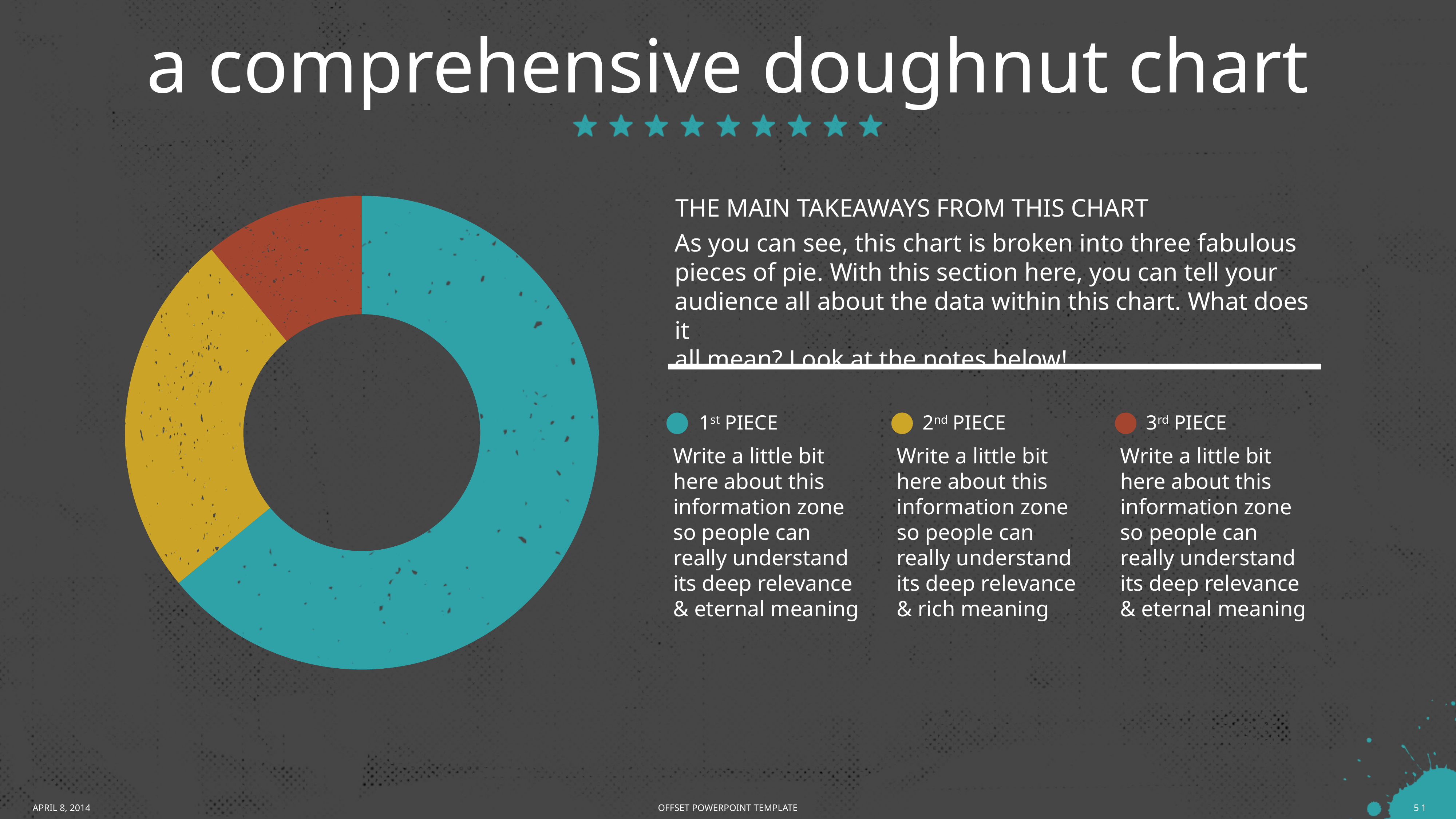
What is the title of the slide containing the doughnut chart? a comprehensive doughnut chart Which piece takes up the largest share of the doughnut chart? 1st PIECE What kind of chart is shown on the slide? Doughnut chart Which is larger in the doughnut chart, the 1st PIECE or the 2nd PIECE? 1st PIECE What colour represents the 2nd PIECE in the doughnut chart? Yellow Does the 1st PIECE take up more or less than half of the doughnut chart? more Which piece takes up the smallest share of the doughnut chart? 3rd PIECE How many pieces (categories) does the doughnut chart have? 3 Which is larger in the doughnut chart, the 2nd PIECE or the 3rd PIECE? 2nd PIECE